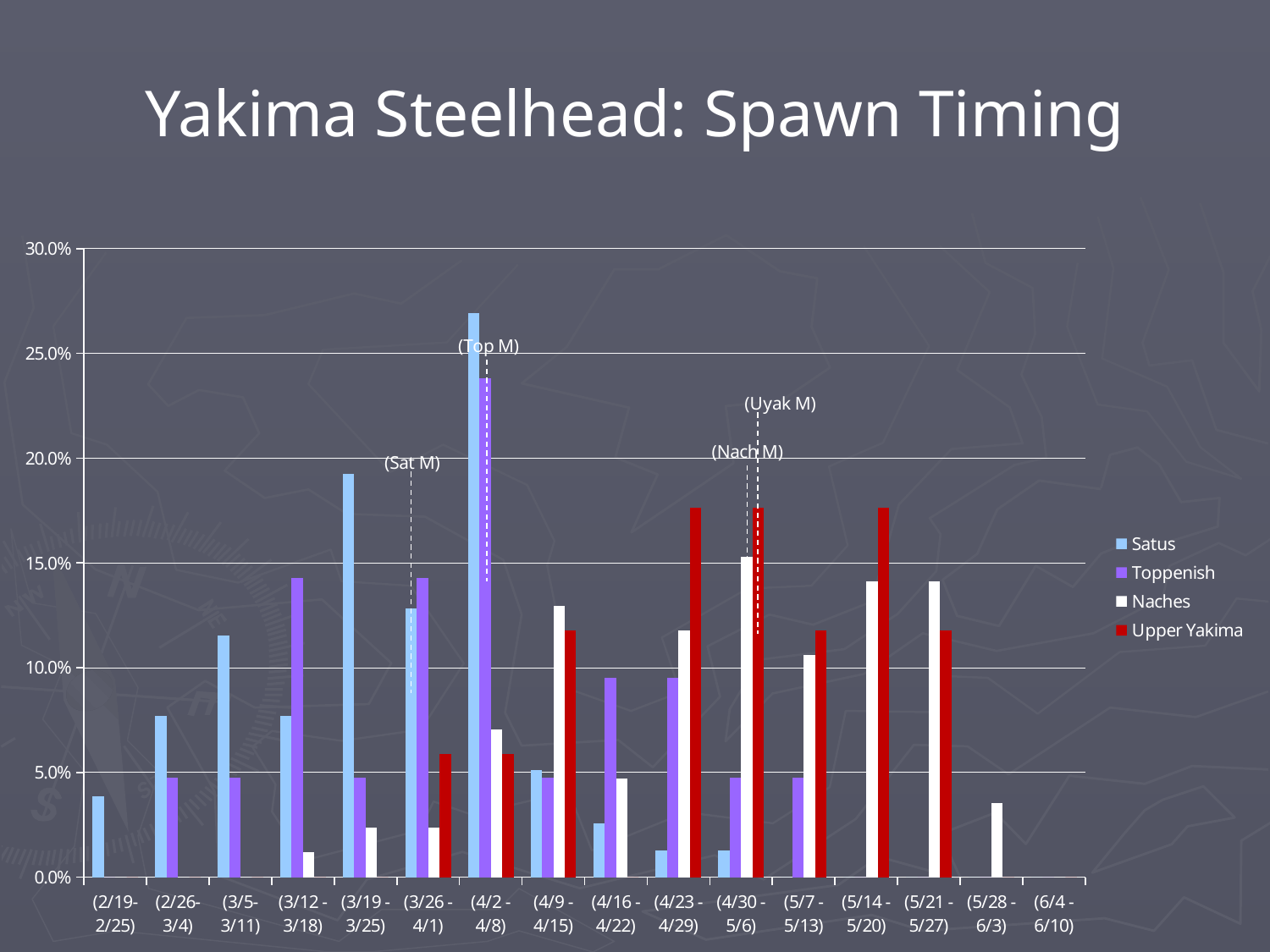
In which period is the Satus value highest? (4/2 - 4/8) Is the Toppenish value for (3/12 - 3/18) greater or less than 10.0%? greater In which period is the Toppenish value highest? (4/2 - 4/8) How many weekly periods are shown along the x axis? 16 In which period is the Naches value highest? (4/30 - 5/6) Is the Naches value for (5/28 - 6/3) greater or less than 5.0%? less What kind of chart is shown on the slide? bar chart What is the title of the chart? Yakima Steelhead: Spawn Timing For the period (5/14 - 5/20), which is larger: Naches or Upper Yakima? Upper Yakima Is the Satus value for (3/19 - 3/25) greater or less than 15.0%? greater How many series does the legend list? 4